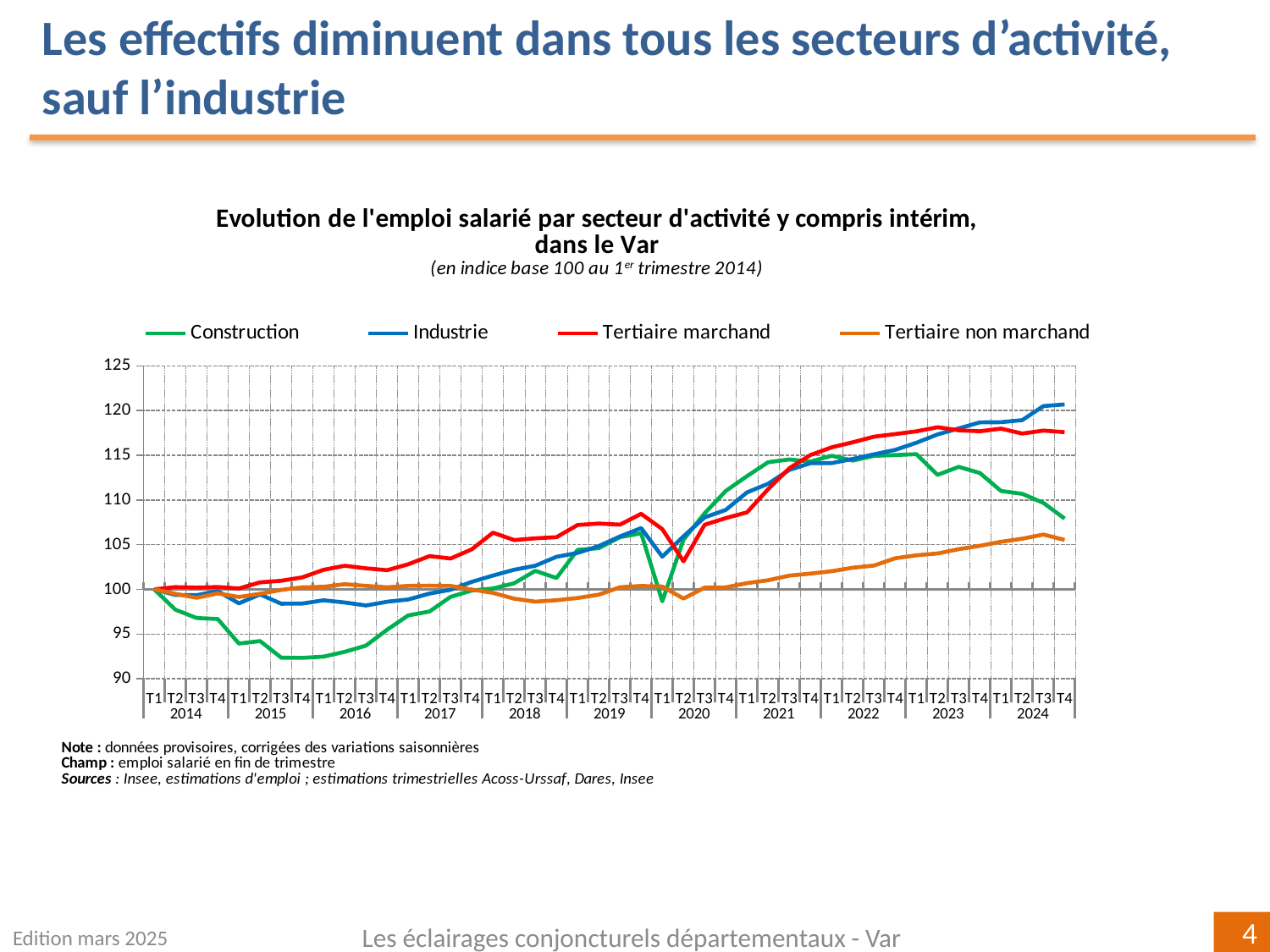
What is the index value of all series at T1 2014? 100 Is the value for Industrie at T4 2024 greater or less than 115? greater Is the value for Construction at T3 2015 greater or less than 95? less How many years are labelled along the x axis? 11 Which colour is used for the Tertiaire marchand series? red At T4 2024, which is higher: Industrie or Construction? Industrie Is the value for Construction at T4 2024 greater or less than 110? less What kind of chart is shown on the slide? line chart How many series does the legend list? 4 Which series has the lowest value at T4 2024? Tertiaire non marchand Which series has the highest value at T4 2024? Industrie Does the Construction series rise or fall between T1 2023 and T4 2024? fall